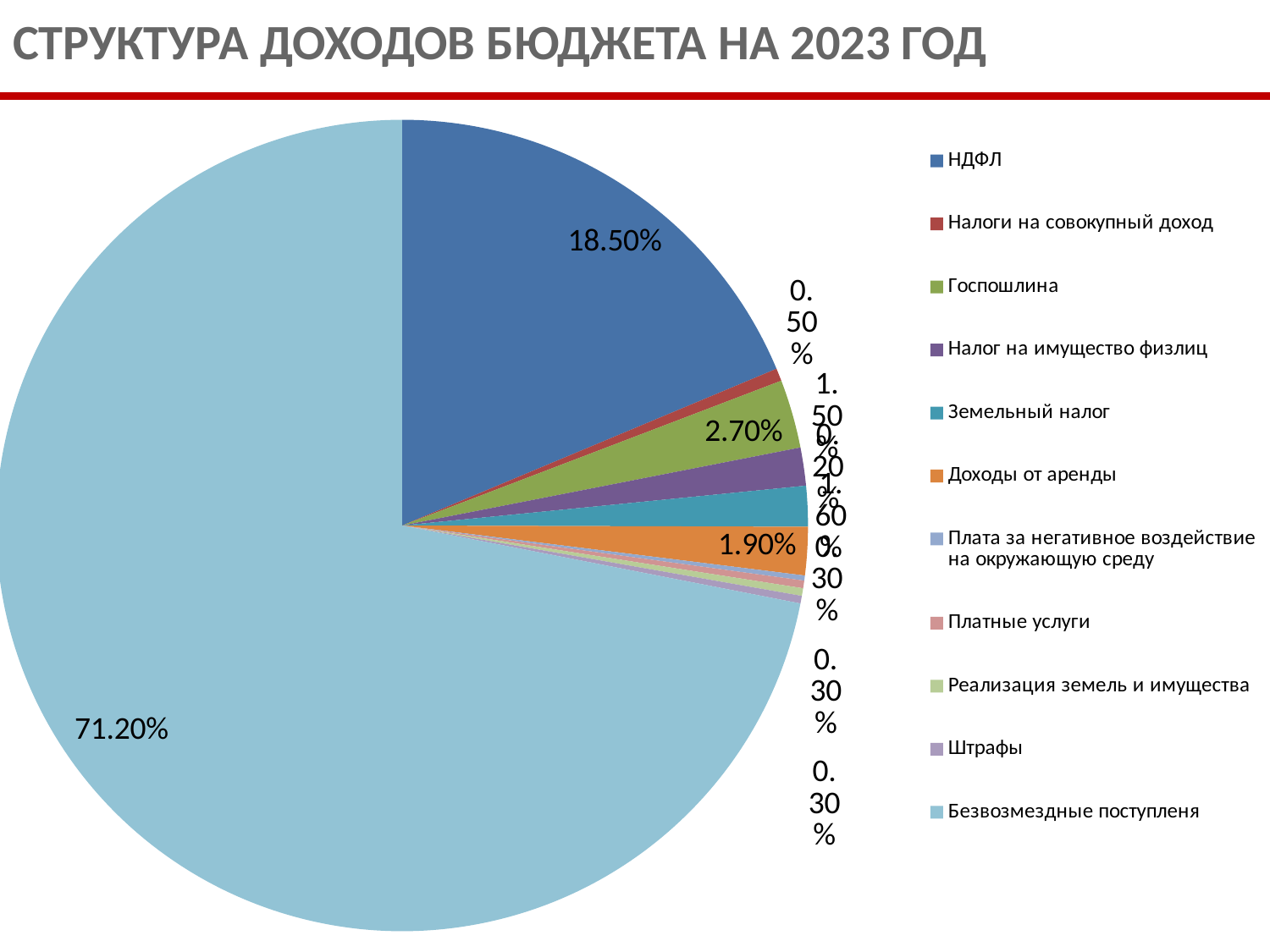
What share of the pie does Безвозмездные поступленя have? 71.20% What kind of chart is shown on the slide? pie chart What is the difference between the share for НДФЛ and the share for Госпошлина? 15.80% What is the difference between the share for Безвозмездные поступленя and the share for НДФЛ? 52.70% Which is larger, the slice for НДФЛ or the slice for Госпошлина? НДФЛ How many categories does the legend list? 11 What share of the pie does НДФЛ have? 18.50% Which category has the largest slice of the pie? Безвозмездные поступленя What share of the pie does Доходы от аренды have? 1.90% Which is larger, the slice for Госпошлина or the slice for Доходы от аренды? Госпошлина What is the title of the slide containing the chart? СТРУКТУРА ДОХОДОВ БЮДЖЕТА НА 2023 ГОД What share of the pie does Госпошлина have? 2.70%